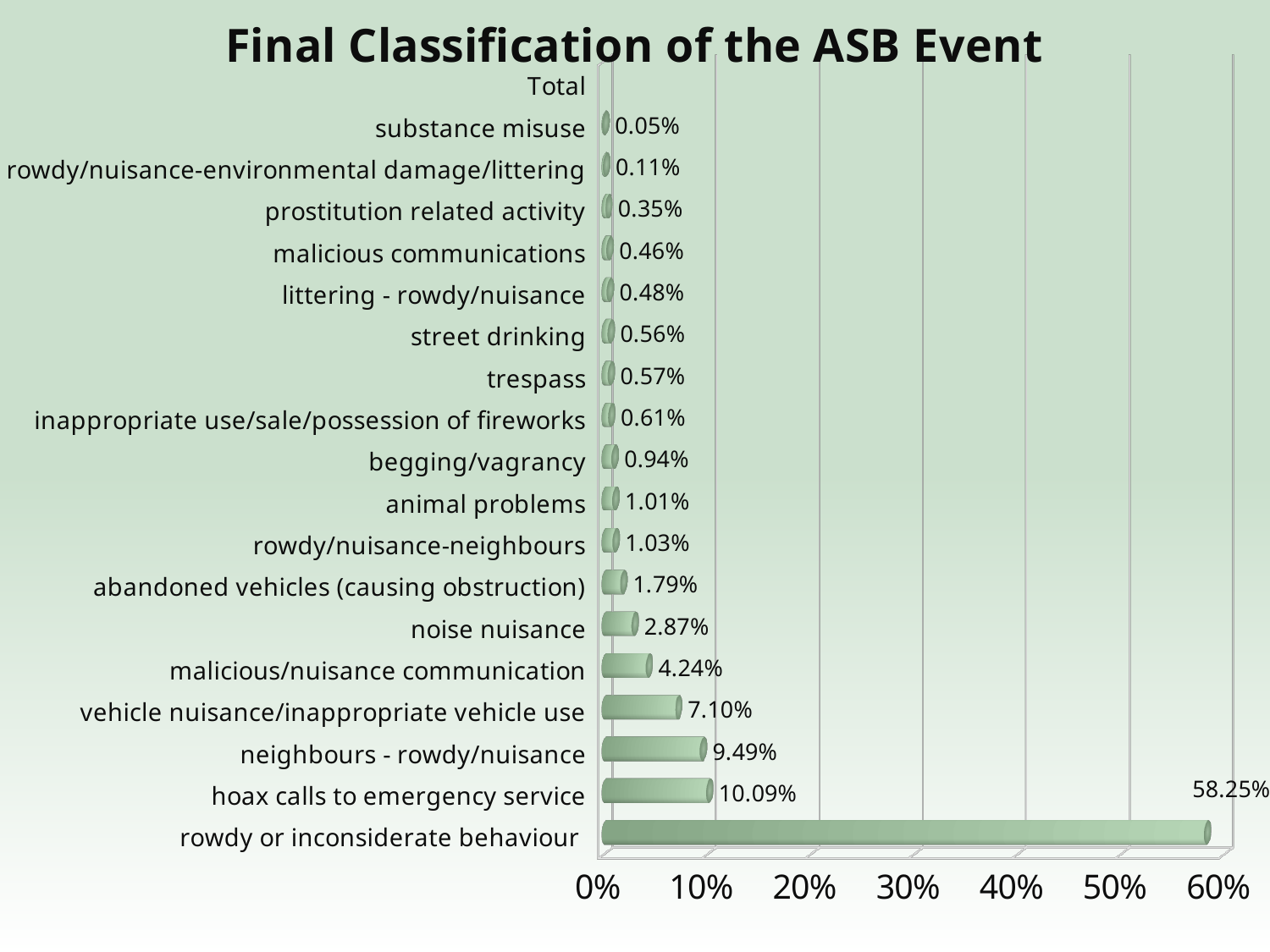
What is the difference between the values for vehicle nuisance/inappropriate vehicle use and malicious/nuisance communication? 2.86% What type of chart is shown on the slide? bar chart What is the difference between the values for rowdy or inconsiderate behaviour and hoax calls to emergency service? 48.16% What is the value for noise nuisance? 2.87% What is the value for hoax calls to emergency service? 10.09% What is the value for street drinking? 0.56% Which category has the lowest value? substance misuse Is the value for rowdy or inconsiderate behaviour greater or less than 50%? greater Which is larger, the value for neighbours - rowdy/nuisance or the value for abandoned vehicles (causing obstruction)? neighbours - rowdy/nuisance Which category has the highest value? rowdy or inconsiderate behaviour What is the title of the chart? Final Classification of the ASB Event